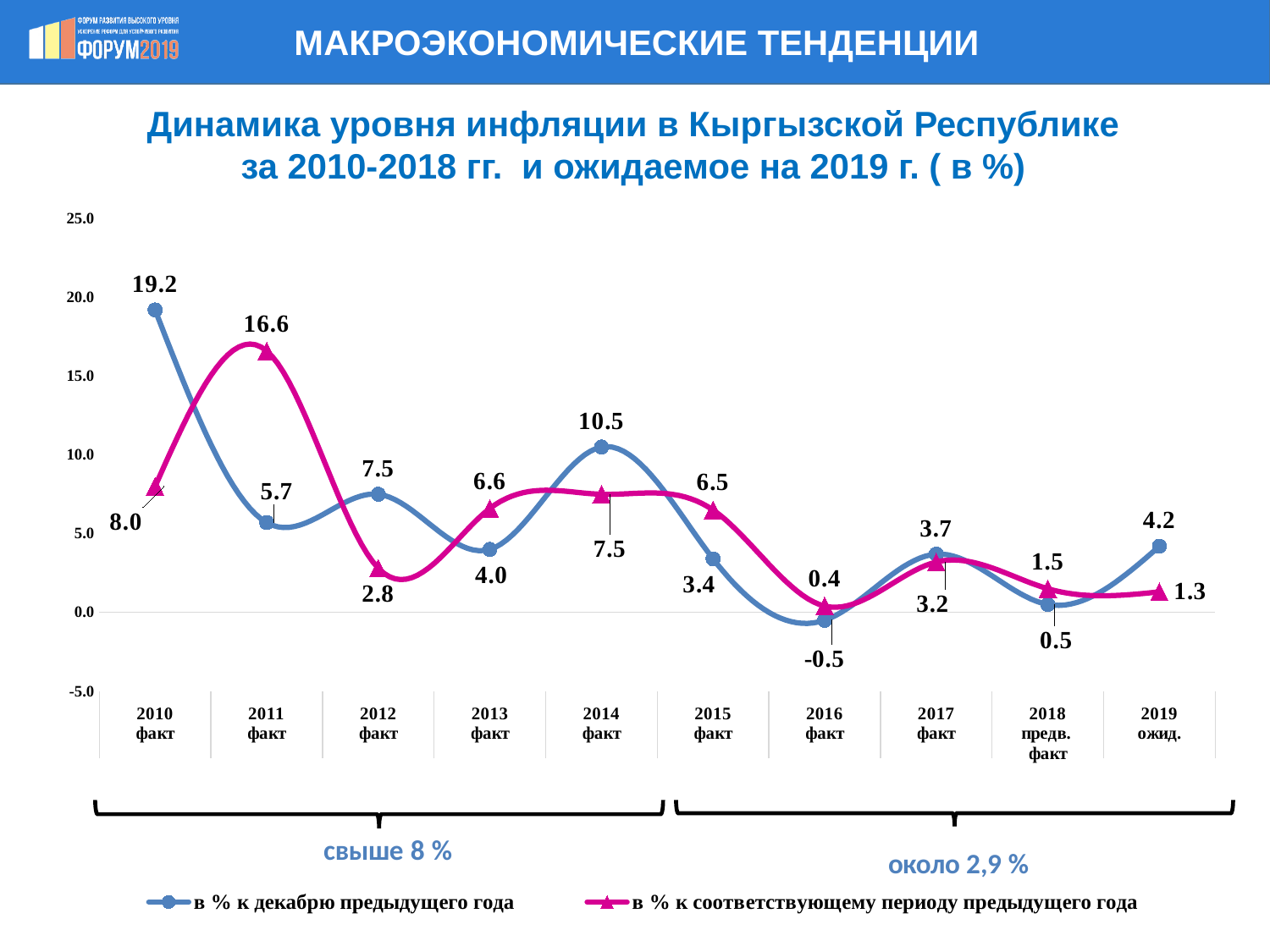
What is the difference between the 2014 values of the two series (10.5 and 7.5)? 3.0 What is the value for 2016 in the series 'в % к декабрю предыдущего года'? -0.5 How many years (categories) are plotted along the x axis? 10 What is the value for 2010 in the series 'в % к декабрю предыдущего года'? 19.2 Which series has the larger value in 2013? в % к соответствующему периоду предыдущего года Which colour is used for the series 'в % к декабрю предыдущего года'? blue In which year is the series 'в % к соответствующему периоду предыдущего года' lowest? 2016 How many series does the legend list? 2 What is the value for 2011 in the series 'в % к соответствующему периоду предыдущего года'? 16.6 What is the expected 2019 value in the series 'в % к соответствующему периоду предыдущего года'? 1.3 What type of chart is shown on the slide? line chart In which year is the series 'в % к декабрю предыдущего года' highest? 2010